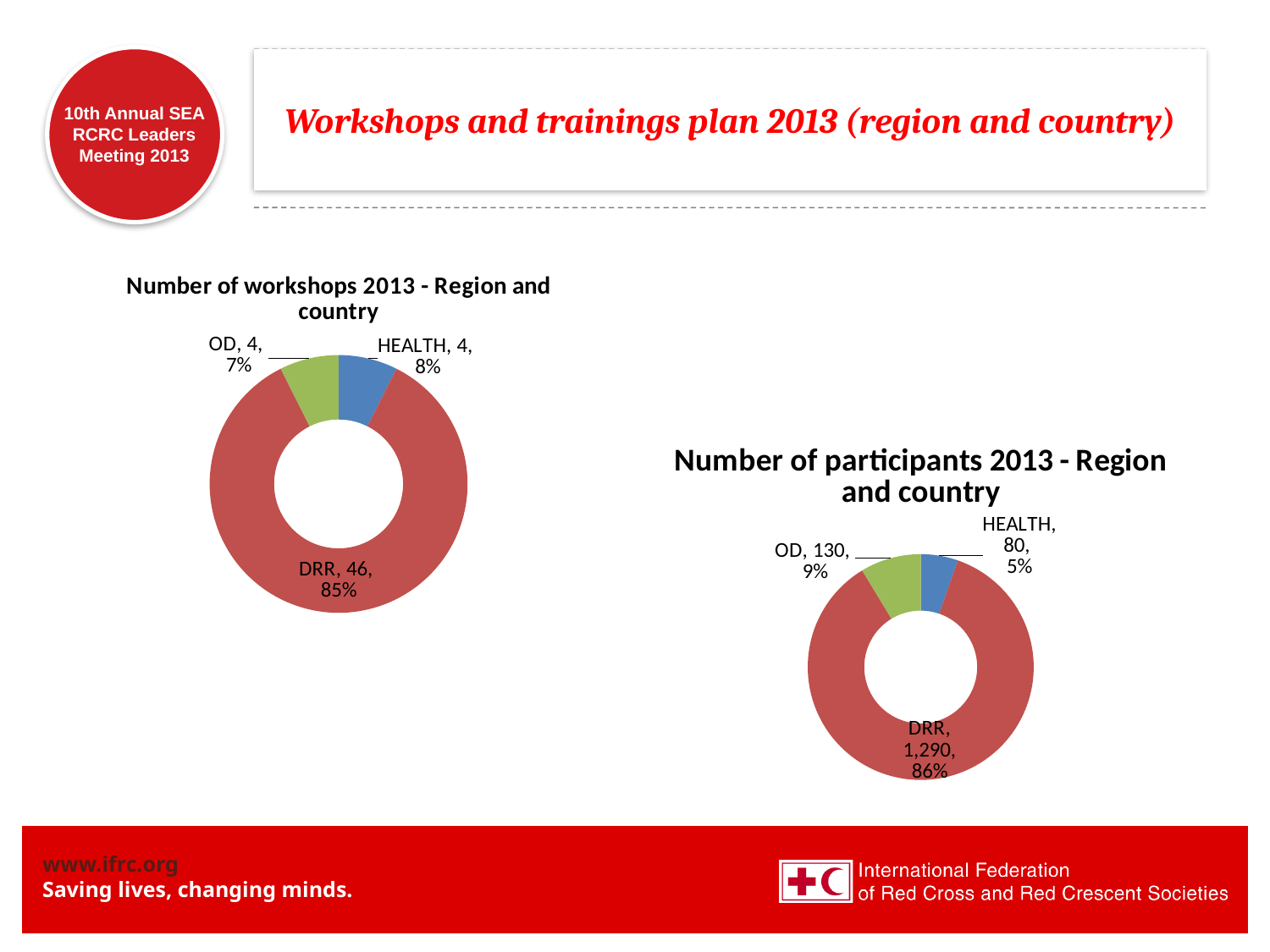
In the 'Number of participants 2013 - Region and country' chart, what is the difference between the OD and HEALTH participant counts? 50 In the 'Number of participants 2013 - Region and country' chart, how many participants are shown for OD? 130 In the 'Number of workshops 2013 - Region and country' chart, which category has the largest slice? DRR In the 'Number of workshops 2013 - Region and country' chart, what share of workshops does DRR account for? 85% In the 'Number of participants 2013 - Region and country' chart, which has more participants, OD or HEALTH? OD In the 'Number of workshops 2013 - Region and country' chart, what percentage is shown for HEALTH? 8% In the 'Number of participants 2013 - Region and country' chart, how many participants are shown for DRR? 1,290 In the 'Number of workshops 2013 - Region and country' chart, how many workshops are planned for DRR? 46 In the 'Number of workshops 2013 - Region and country' chart, how many categories are shown? 3 What type of chart is used for the 'Number of workshops 2013 - Region and country' chart? Doughnut (pie) chart In the 'Number of participants 2013 - Region and country' chart, which category has the smallest number of participants? HEALTH In the 'Number of participants 2013 - Region and country' chart, what share of participants does HEALTH account for? 5%